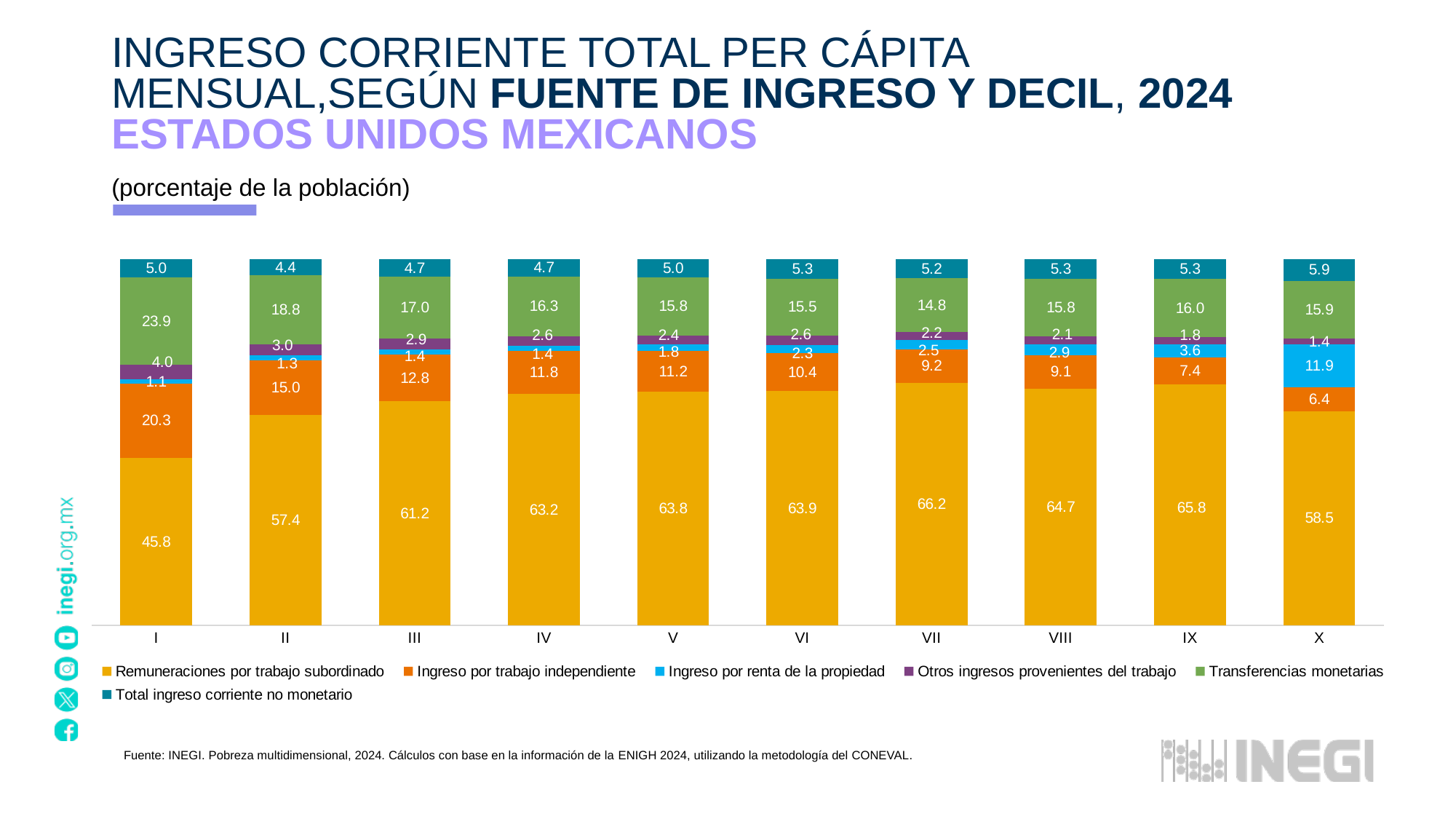
What kind of chart is shown on the slide? stacked bar chart What is the value of Remuneraciones por trabajo subordinado for decile I? 45.8 What is the total of the stacked bar for decile X? 100.0 Which decile has the highest value for Remuneraciones por trabajo subordinado? VII How many series does the legend list? 6 Which is larger, the Total ingreso corriente no monetario value for decile X or for decile II? decile X Which decile has the lowest value for Ingreso por trabajo independiente? X What is the value of Ingreso por renta de la propiedad for decile X? 11.9 Does the value of Ingreso por trabajo independiente rise or fall from decile I to decile X? fall What is the difference between the Transferencias monetarias values for decile I and decile II? 5.1 How many deciles are shown on the x axis? 10 What is the value of Transferencias monetarias for decile VII? 14.8